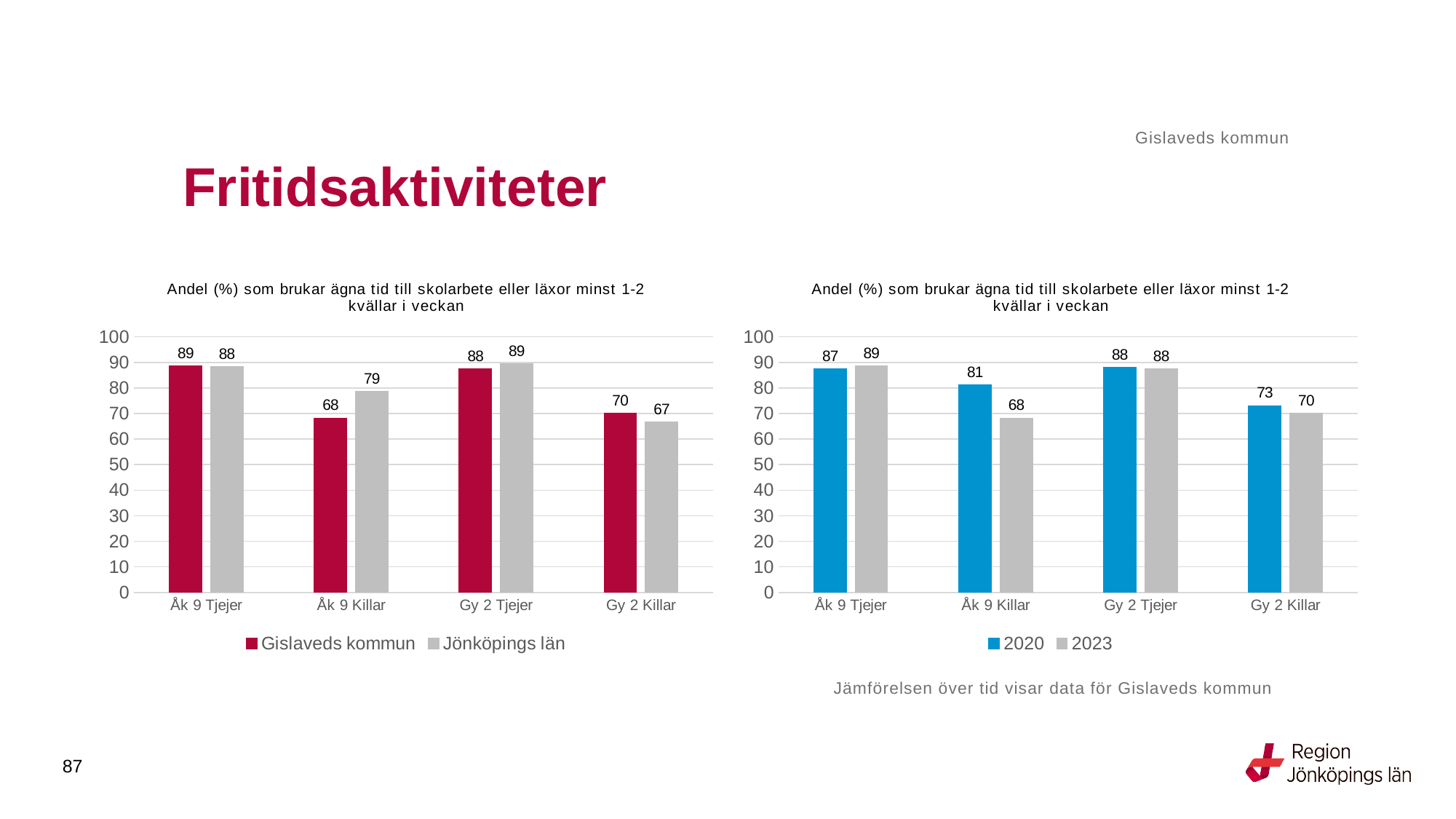
In the left chart, what is the value for Jönköpings län for Gy 2 Killar? 67 In the right chart, what is the value for 2023 for Gy 2 Killar? 70 In the left chart, what is the difference between Jönköpings län and Gislaveds kommun for Åk 9 Killar? 11 How many categories are shown on the x axis of the left chart? 4 In the right chart, what is the value for 2020 for Åk 9 Killar? 81 In the left chart, which category has the lowest value for Gislaveds kommun? Åk 9 Killar In the left chart, what is the value for Gislaveds kommun for Åk 9 Killar? 68 In the right chart, which category has the highest value for 2023? Åk 9 Tjejer How many series does the legend of the right chart list? 2 In the right chart, which is larger for Gy 2 Killar: 2020 or 2023? 2020 In the right chart, what is the difference between 2020 and 2023 for Åk 9 Killar? 13 What kind of chart is the left chart? Bar chart